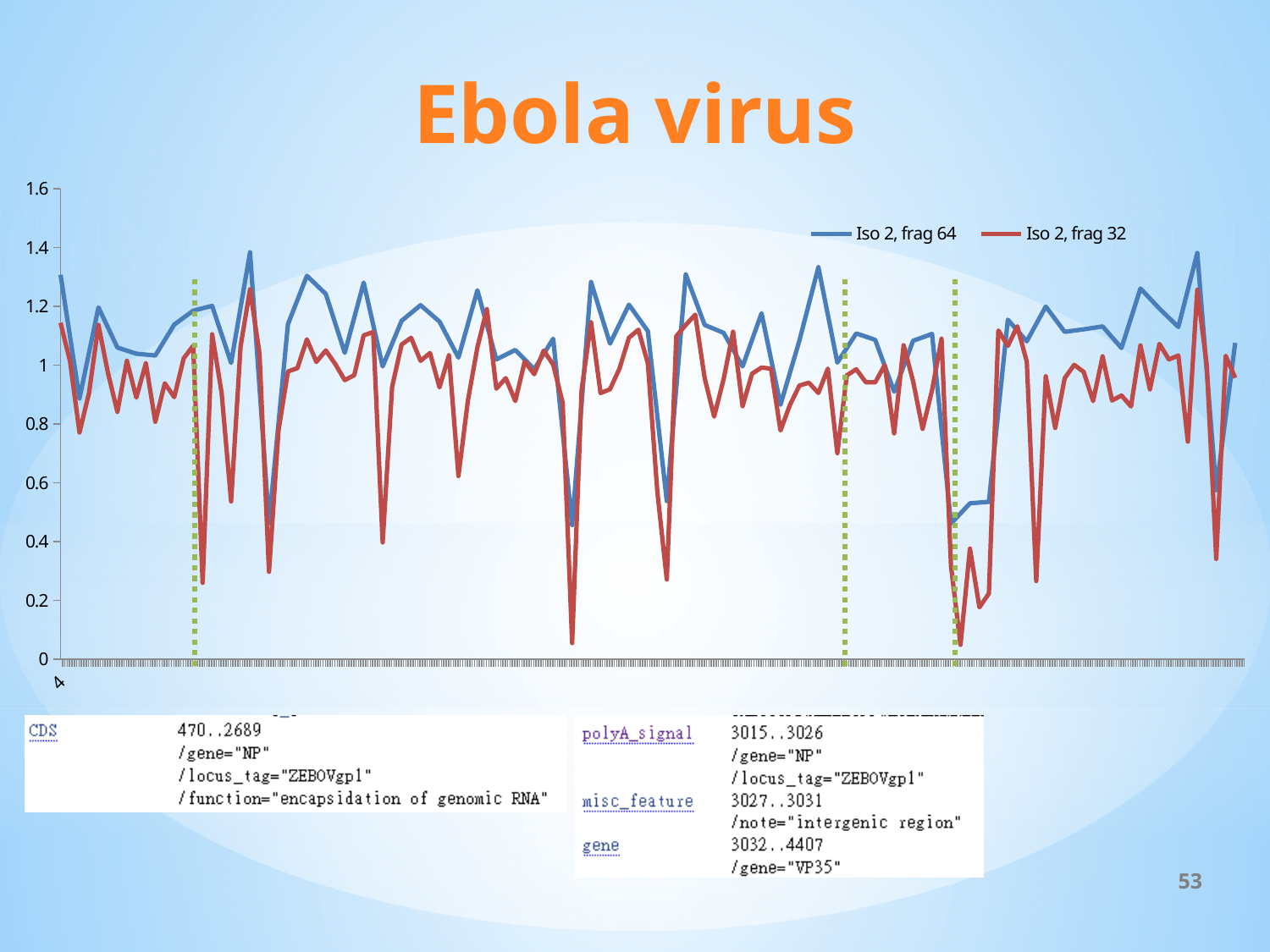
Is the highest value of the Iso 2, frag 64 series greater or less than 1.2? greater Is the lowest value of the Iso 2, frag 64 series greater or less than 0.6? less How many series does the chart legend list? 2 What kind of chart is shown on the slide? line chart Which series reaches the lower minimum value, Iso 2, frag 64 or Iso 2, frag 32? Iso 2, frag 32 Is the lowest value of the Iso 2, frag 32 series greater or less than 0.2? less Which colour is used for the Iso 2, frag 32 series? red What are the two series named in the chart legend? Iso 2, frag 64 and Iso 2, frag 32